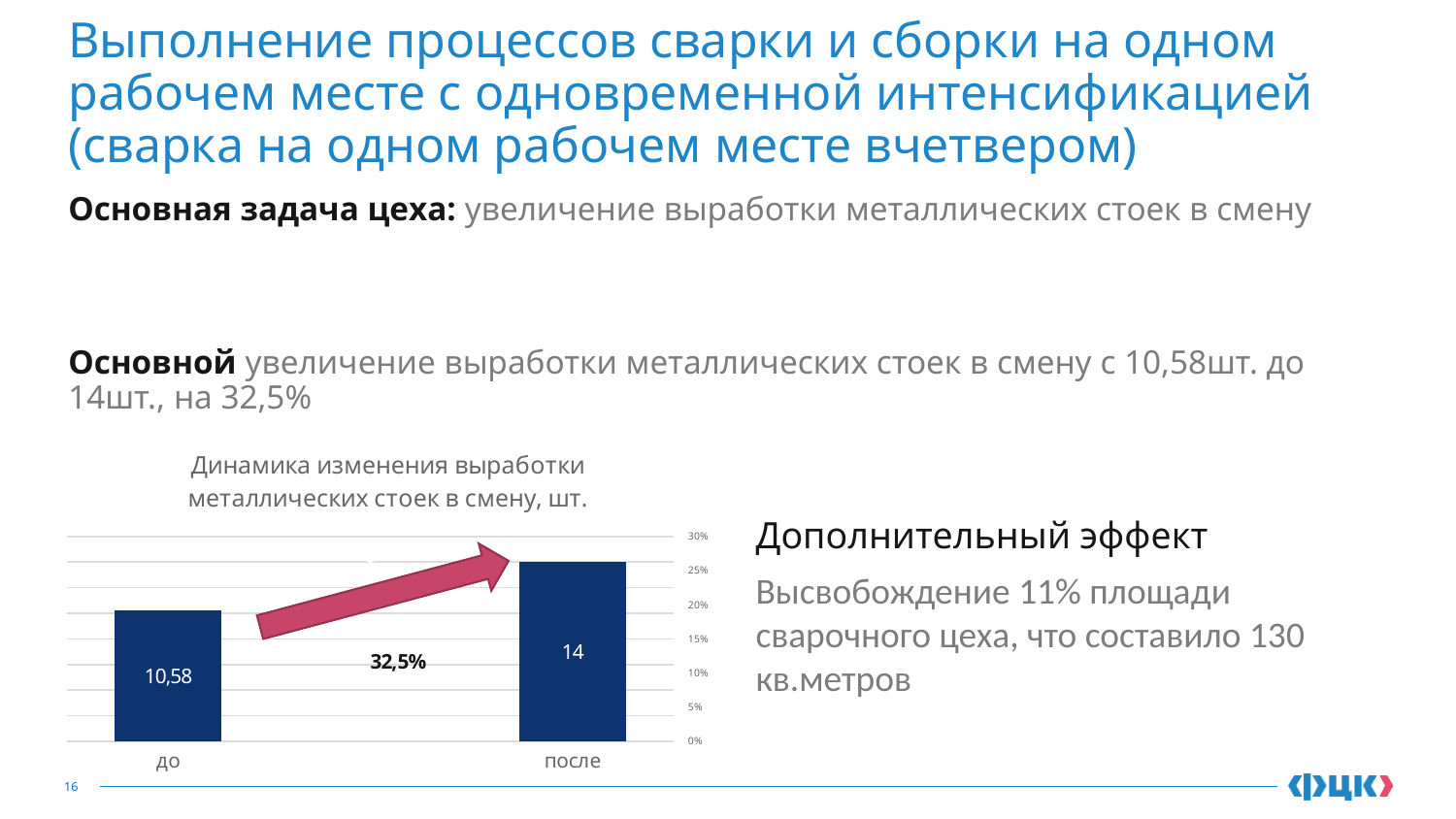
What is the difference between the values for "после" and "до"? 3,42 Which category has the lowest value in the chart? до Do the values rise or fall from "до" to "после"? rise What is the value for "после" in the chart? 14 What is the title of the chart? Динамика изменения выработки металлических стоек в смену, шт. Which category has the highest value in the chart? после What is the value for "до" in the chart? 10,58 What percentage is printed on the arrow between the two bars? 32,5% How many categories are shown on the x axis of the chart? 2 What kind of chart is shown on the slide? bar chart Which is larger, the value for "до" or the value for "после"? после